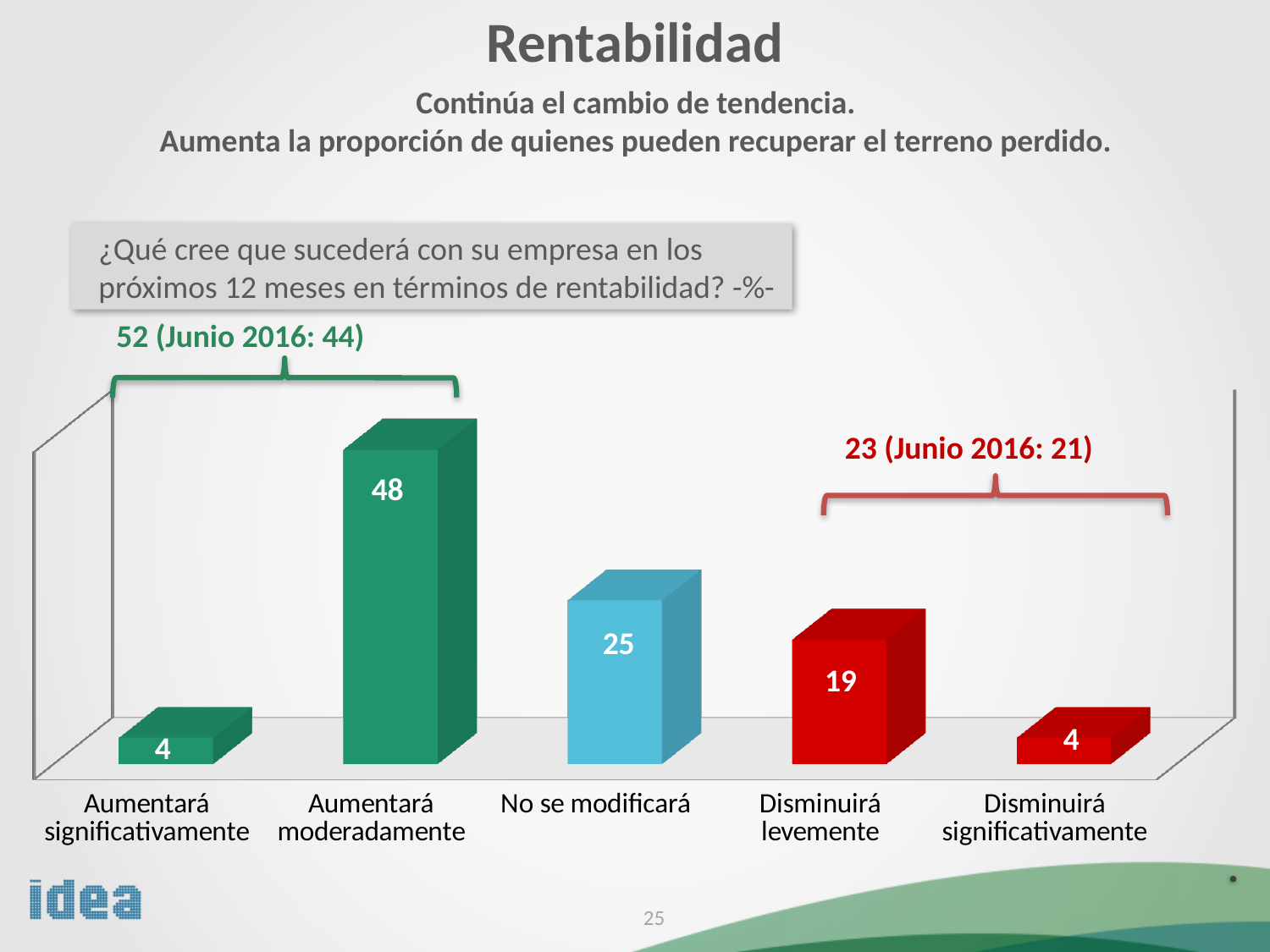
What is the value for "Aumentará moderadamente"? 48 What is the combined value of the two "Disminuirá" categories, as shown by the red bracket label? 23 Which is larger, the value for "No se modificará" or the value for "Disminuirá levemente"? No se modificará Which category has the highest value? Aumentará moderadamente What kind of chart is shown on the slide? Bar chart What is the value for "No se modificará"? 25 What is the difference between the values for "Aumentará moderadamente" and "No se modificará"? 23 What is the value for "Aumentará significativamente"? 4 What is the combined value of the two "Aumentará" categories, as shown by the green bracket label? 52 What colour are the bars for the two "Disminuirá" categories? Red What is the value for "Disminuirá levemente"? 19 How many categories are shown in the chart? 5